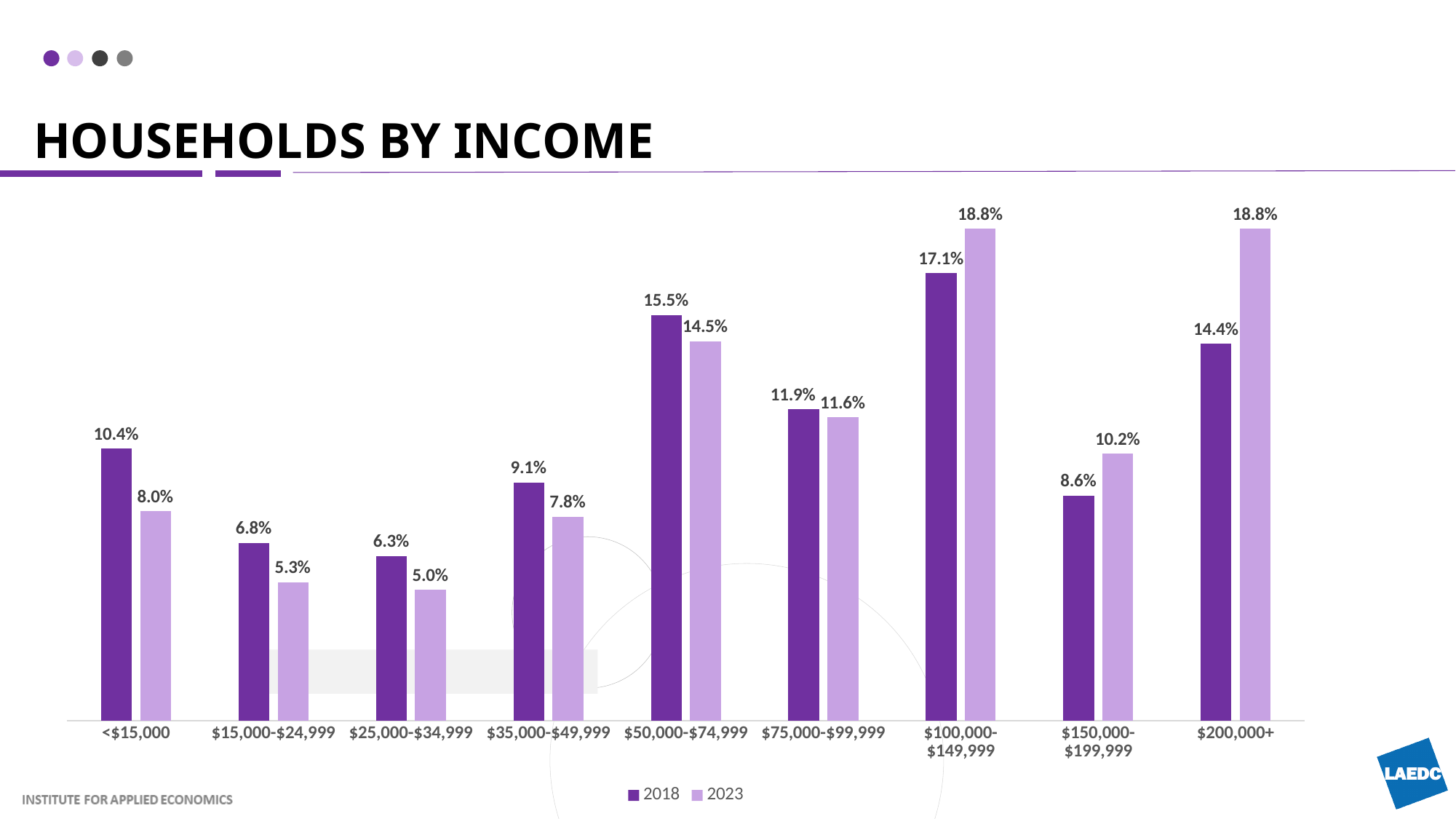
What is the 2018 value for the <$15,000 income category? 10.4% Which is larger for the $50,000-$74,999 category, the 2018 value or the 2023 value? 2018 What is the 2023 value for the $150,000-$199,999 income category? 10.2% Which income category has the lowest 2023 value? $25,000-$34,999 What is the title of the chart? HOUSEHOLDS BY INCOME What is the difference between the 2023 and 2018 values for the $200,000+ category? 4.4% Which series is shown in the lighter purple colour? 2023 How many income categories are shown on the x axis? 9 What kind of chart is shown on the slide? Bar chart Which income category has the highest 2018 value? $100,000-$149,999 What is the 2023 value for the $25,000-$34,999 income category? 5.0% How many series does the legend list? 2